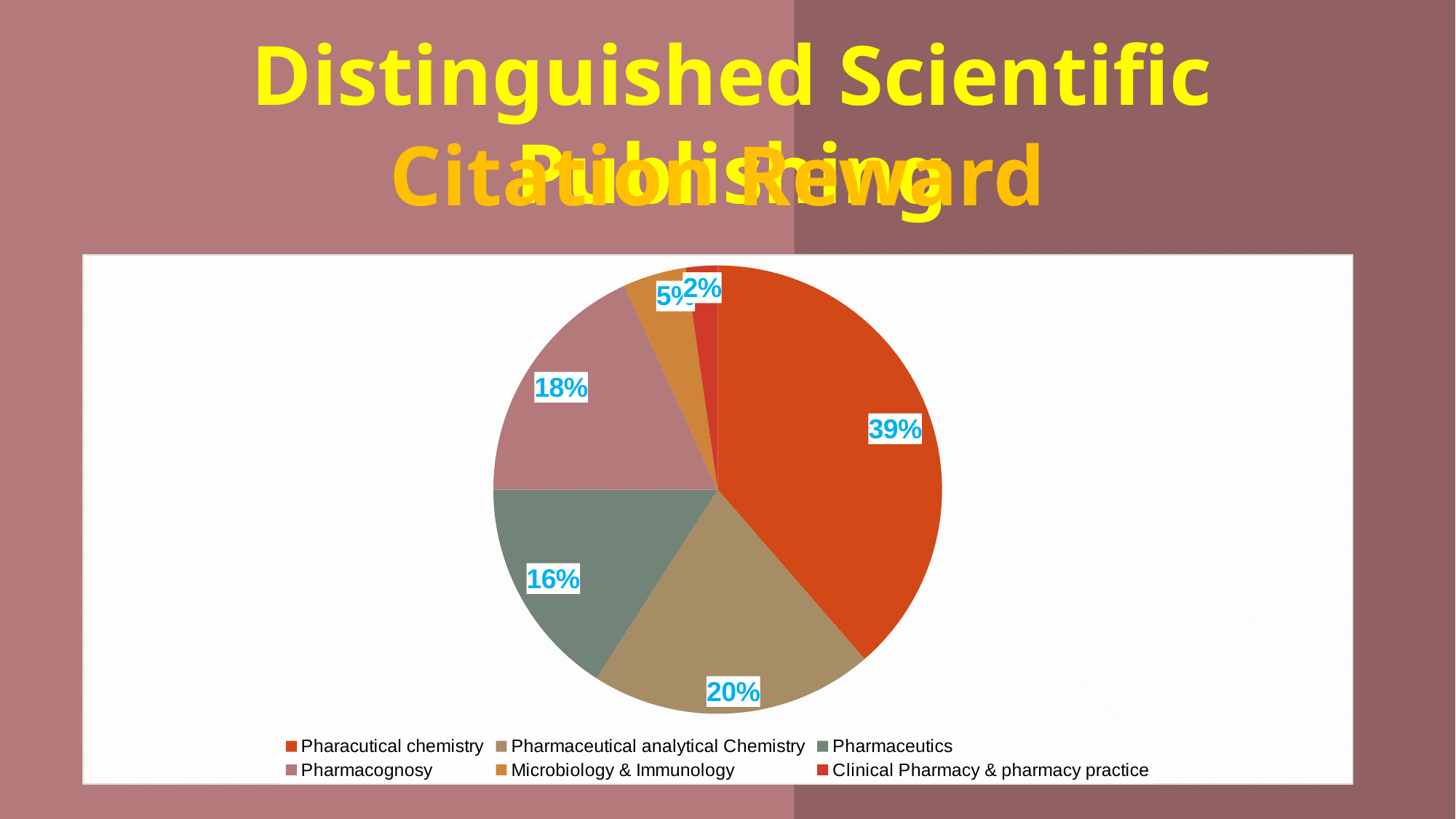
How many categories does the pie chart have? 6 What share of the pie does Microbiology & Immunology have? 5% What is the difference in percentage points between Pharacutical chemistry and Pharmaceutical analytical Chemistry? 19 What share of the pie does Pharmaceutics have? 16% What share of the pie does Pharacutical chemistry have? 39% Which category has the largest slice of the pie? Pharacutical chemistry What colour is the slice for Pharmaceutics? grey-green Which is larger, the share for Pharmacognosy or the share for Pharmaceutics? Pharmacognosy Which category has the smallest slice of the pie? Clinical Pharmacy & pharmacy practice What kind of chart is shown on the slide? pie chart